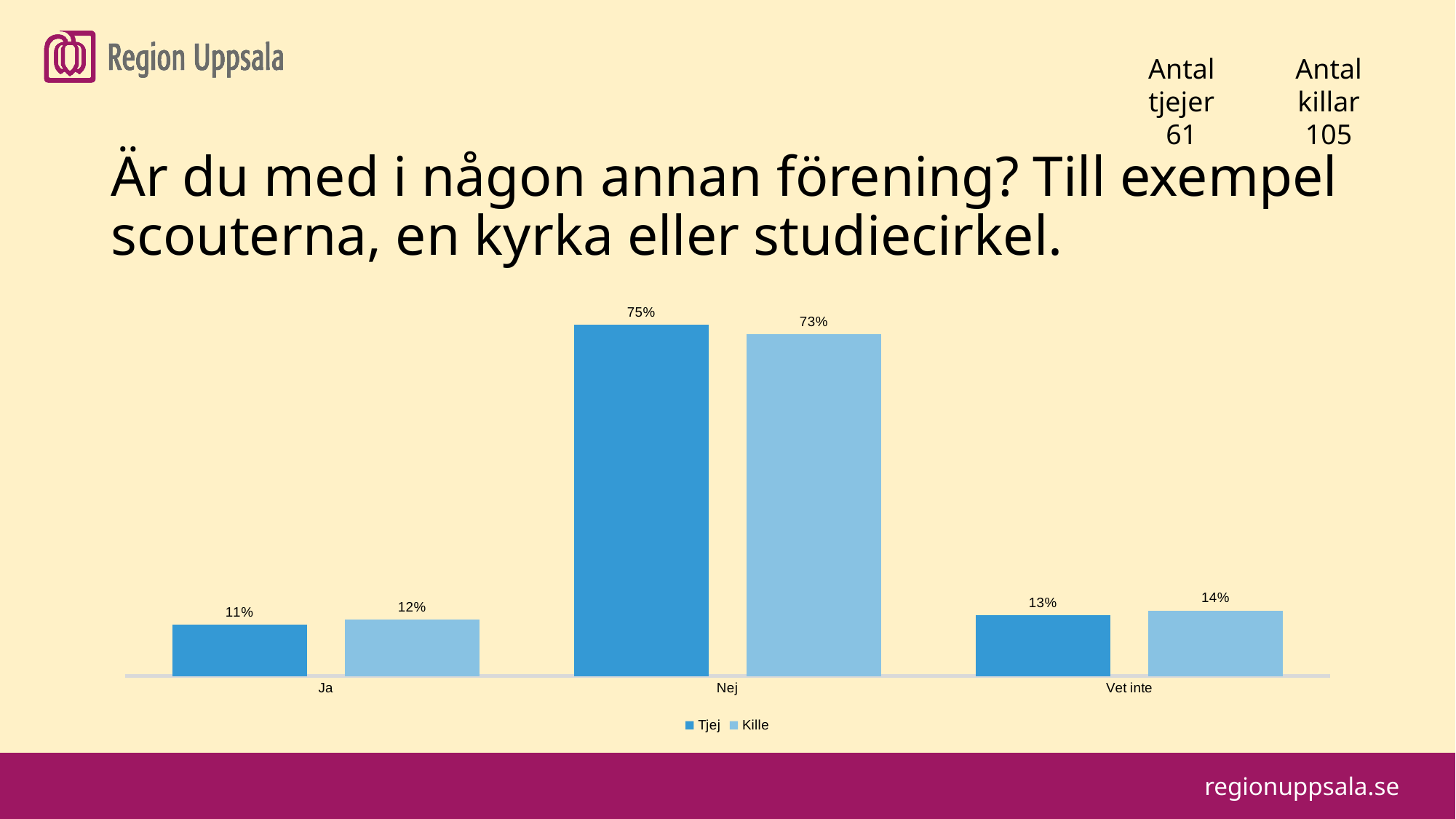
What is the value for Kille in the Ja category? 12% What kind of chart is shown on the slide? Bar chart What is the value for Tjej in the Vet inte category? 13% What is the difference between the Tjej values for Nej and Ja? 64% How many series does the legend list? 2 What is the value for Tjej in the Nej category? 75% What is the difference between the Tjej and Kille values in the Nej category? 2% What are the two series named in the legend? Tjej and Kille Which category has the lowest value for Tjej? Ja How many categories are shown on the x axis? 3 Which category has the highest value for Kille? Nej What is the value for Kille in the Vet inte category? 14%